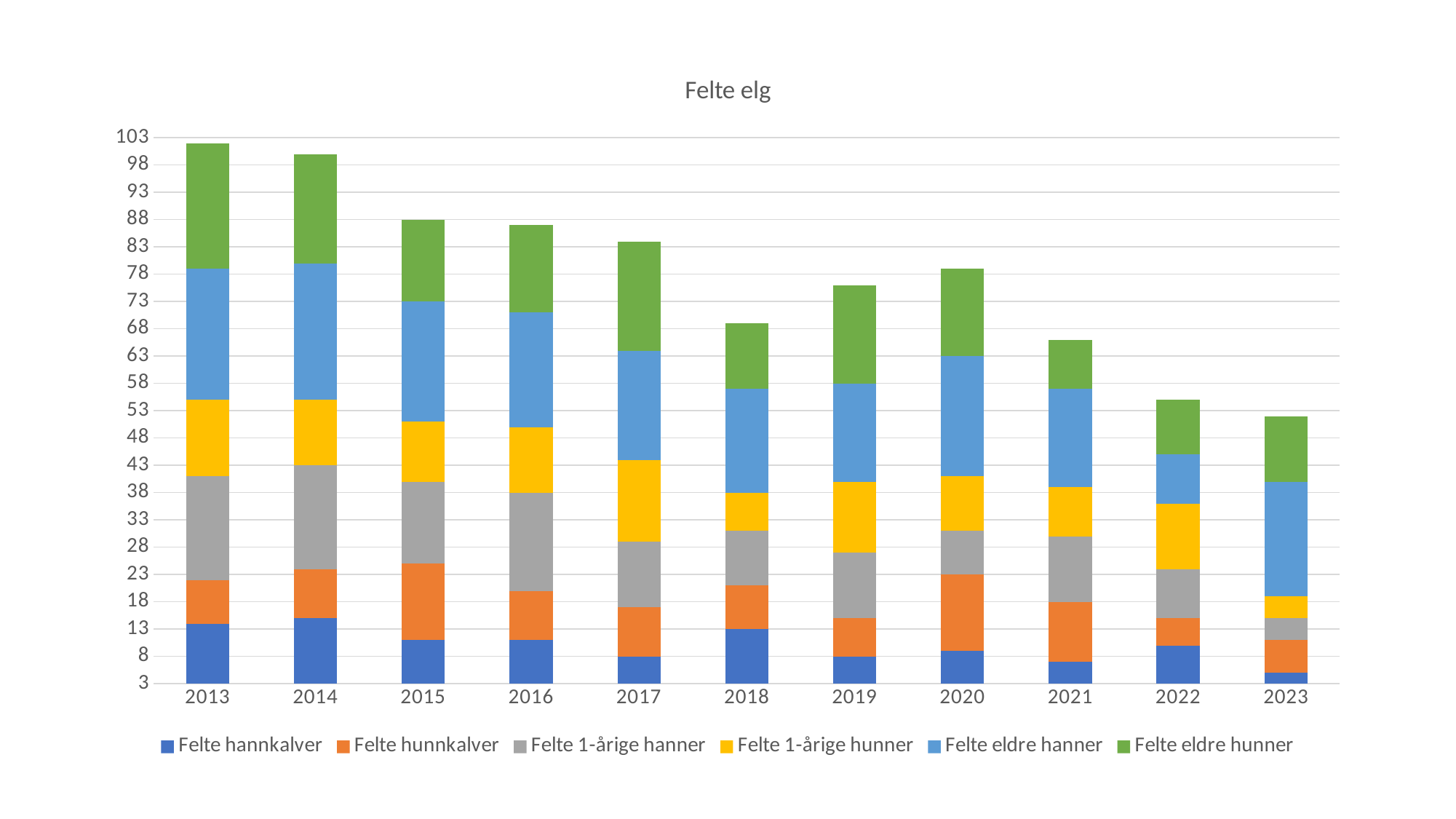
What kind of chart is shown on the slide? stacked bar chart How many years are shown on the x axis? 11 Is the total stacked value for 2018 greater or less than 73? less Do the total stacked values generally rise or fall from 2013 to 2023? fall Which year has the larger total stacked value, 2018 or 2019? 2019 Which series has the largest segment in the 2023 bar? Felte eldre hanner Is the total stacked value for 2013 greater or less than 98? greater Is the total stacked value for 2020 greater or less than 73? greater How many series does the legend list? 6 Which year has the larger total stacked value, 2020 or 2021? 2020 What is the title of the chart? Felte elg